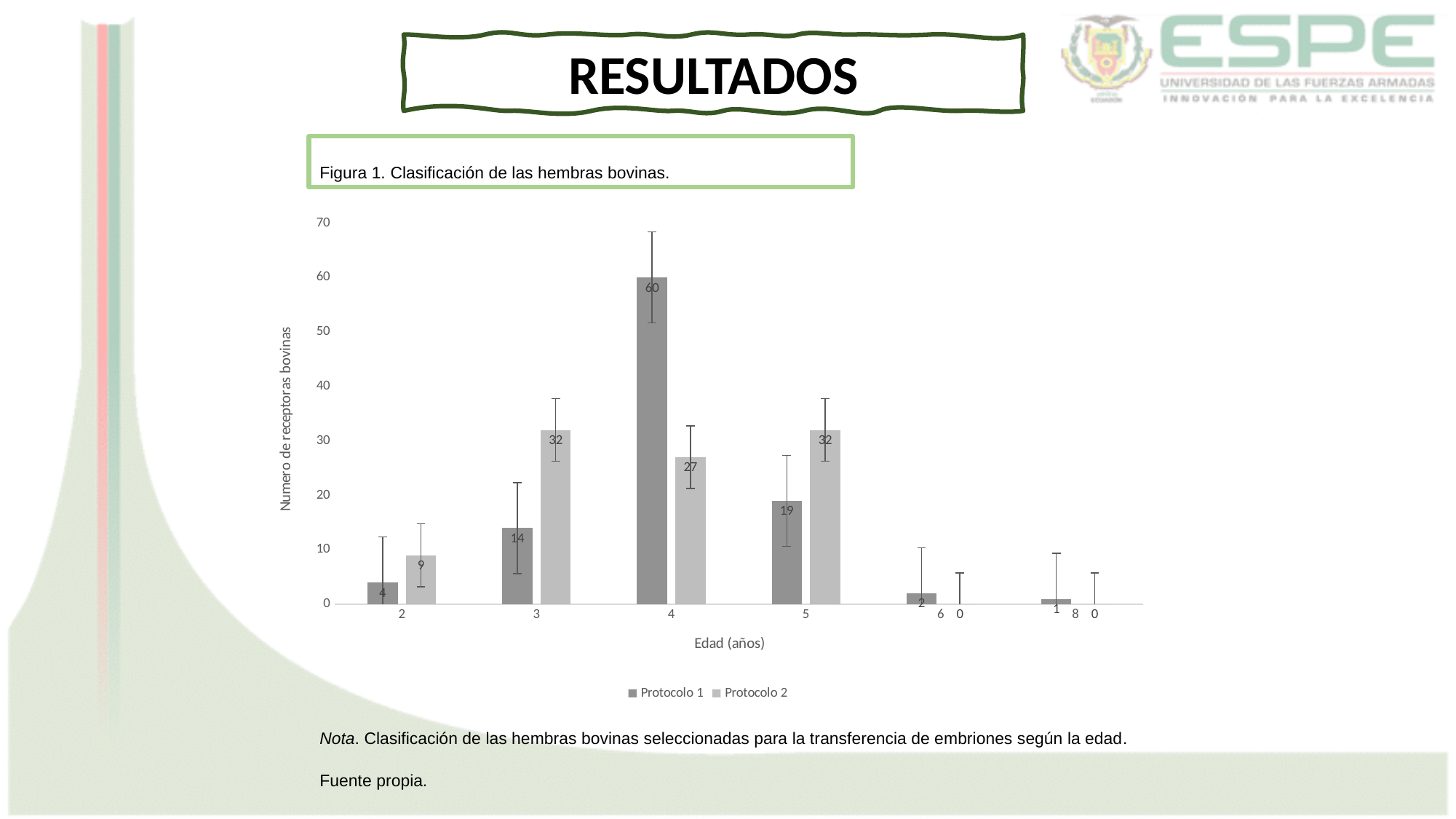
How many series does the legend list? 2 What kind of chart is shown in Figura 1? Bar chart What is the value for Protocolo 1 at age 5? 19 What is the value for Protocolo 2 at age 3? 32 At which age does Protocolo 1 reach its highest value? 4 At which age does Protocolo 1 have its lowest value? 8 How many age categories are shown on the x axis? 6 What is the title of the y axis? Numero de receptoras bovinas At age 4, what is the difference between Protocolo 1 and Protocolo 2? 33 What is the value for Protocolo 1 at age 4 (Edad 4 años)? 60 What is the value for Protocolo 2 at age 6? 0 At age 3, which series has the larger value, Protocolo 1 or Protocolo 2? Protocolo 2